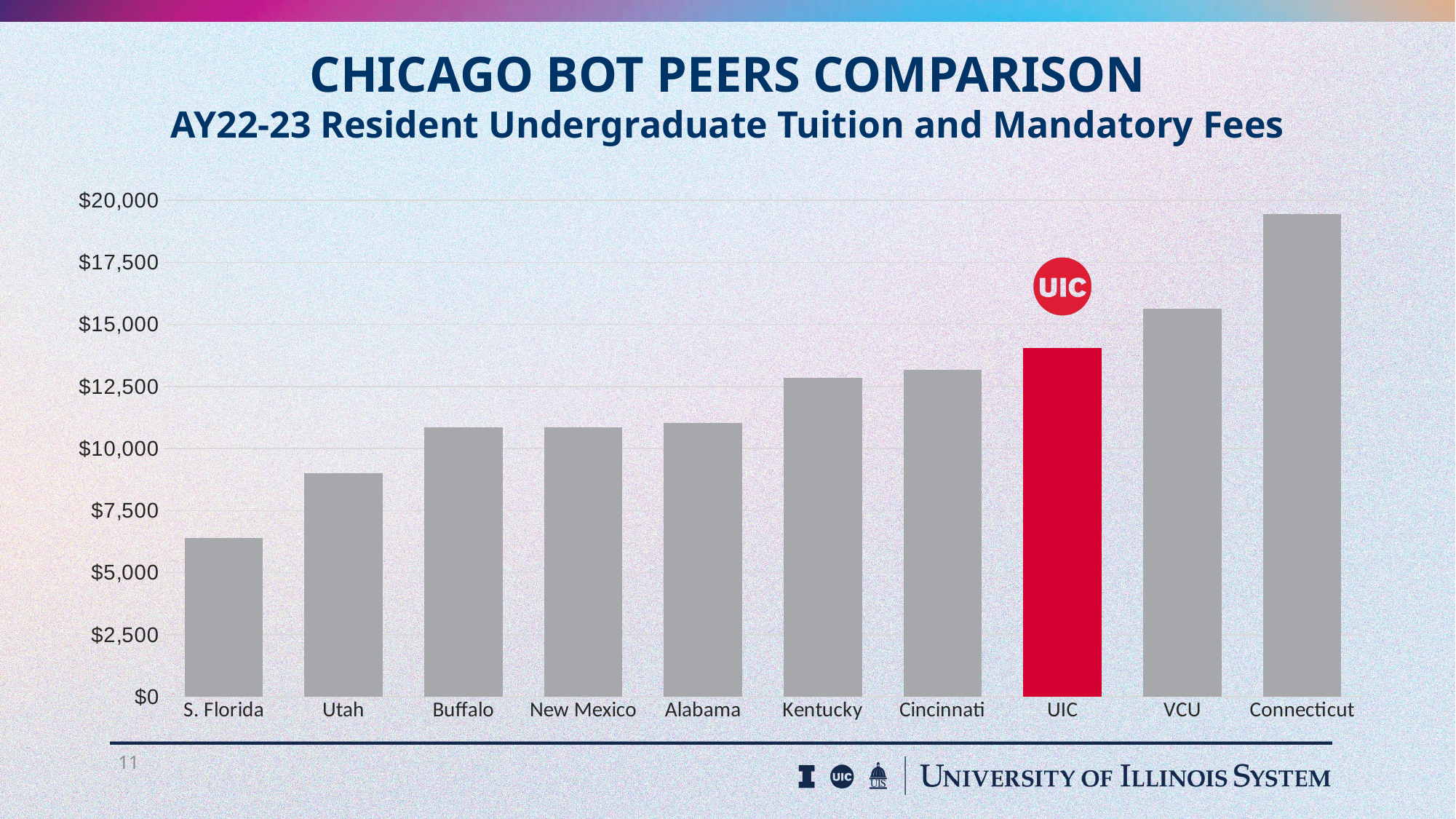
How many institutions are shown on the chart? 10 Is the value for S. Florida greater or less than $7,500? less Which institution has the lowest resident undergraduate tuition and mandatory fees? S. Florida Is the value for Connecticut greater or less than $17,500? greater Do the values generally rise or fall moving from left to right across the chart? rise What kind of chart is shown on the slide? bar chart Is the value for Utah greater or less than $10,000? less Which institution has the highest resident undergraduate tuition and mandatory fees? Connecticut Which is larger, the value for UIC or the value for Cincinnati? UIC Which bar is highlighted in red on the chart? UIC